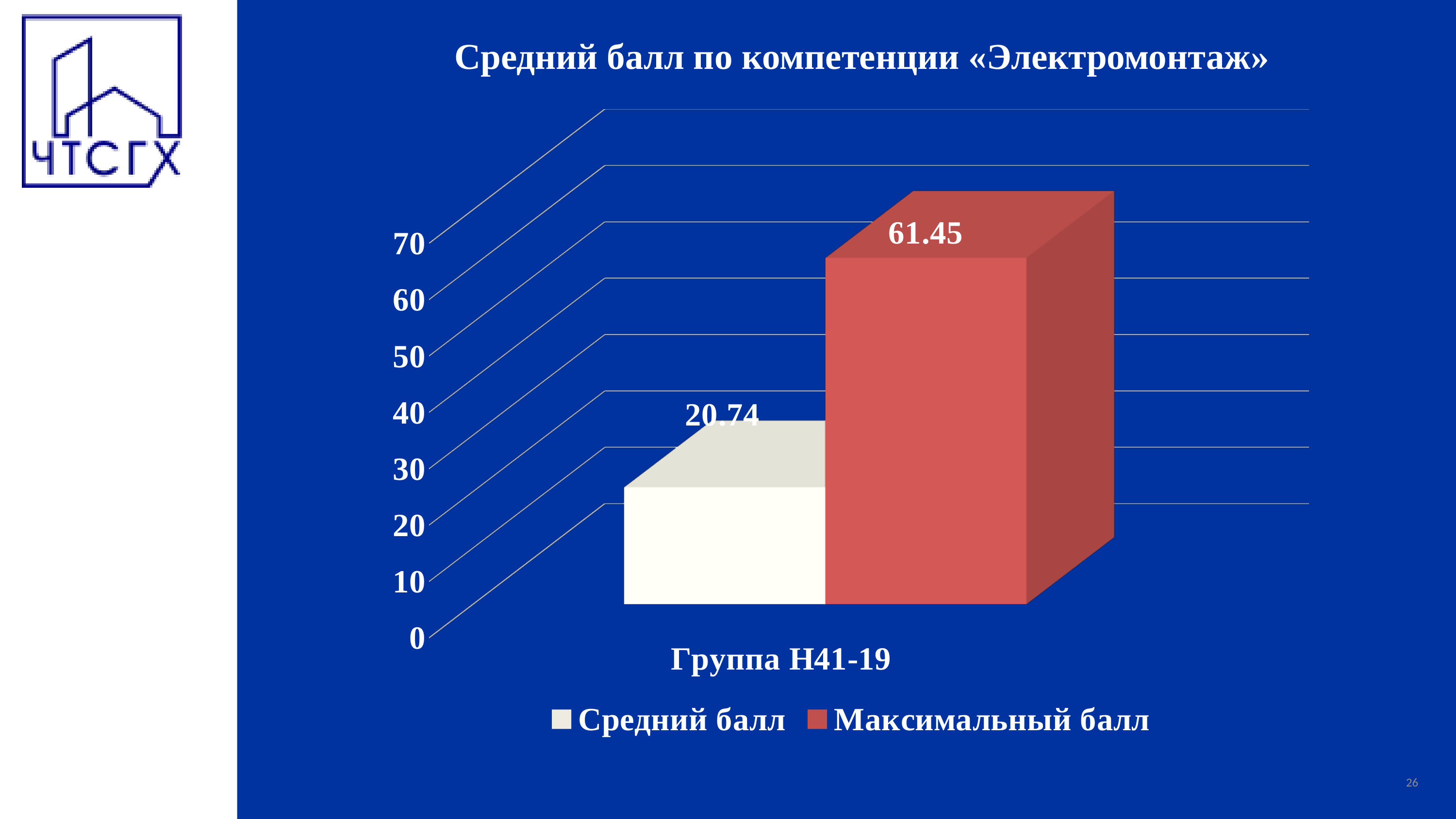
How many categories are shown on the x axis? 1 How many series does the legend list? 2 Is the value of Средний балл for Группа Н41-19 greater or less than 30? less What is the title of the chart? Средний балл по компетенции «Электромонтаж» Is the value of Максимальный балл for Группа Н41-19 greater or less than 60? greater What kind of chart is shown on the slide? bar chart What is the difference between Максимальный балл and Средний балл for Группа Н41-19? 40.71 What is the highest value shown on the vertical axis? 70 What is the value of Средний балл for Группа Н41-19? 20.74 What colour is the bar for Максимальный балл? red What is the value of Максимальный балл for Группа Н41-19? 61.45 Which series has the higher value for Группа Н41-19, Средний балл or Максимальный балл? Максимальный балл